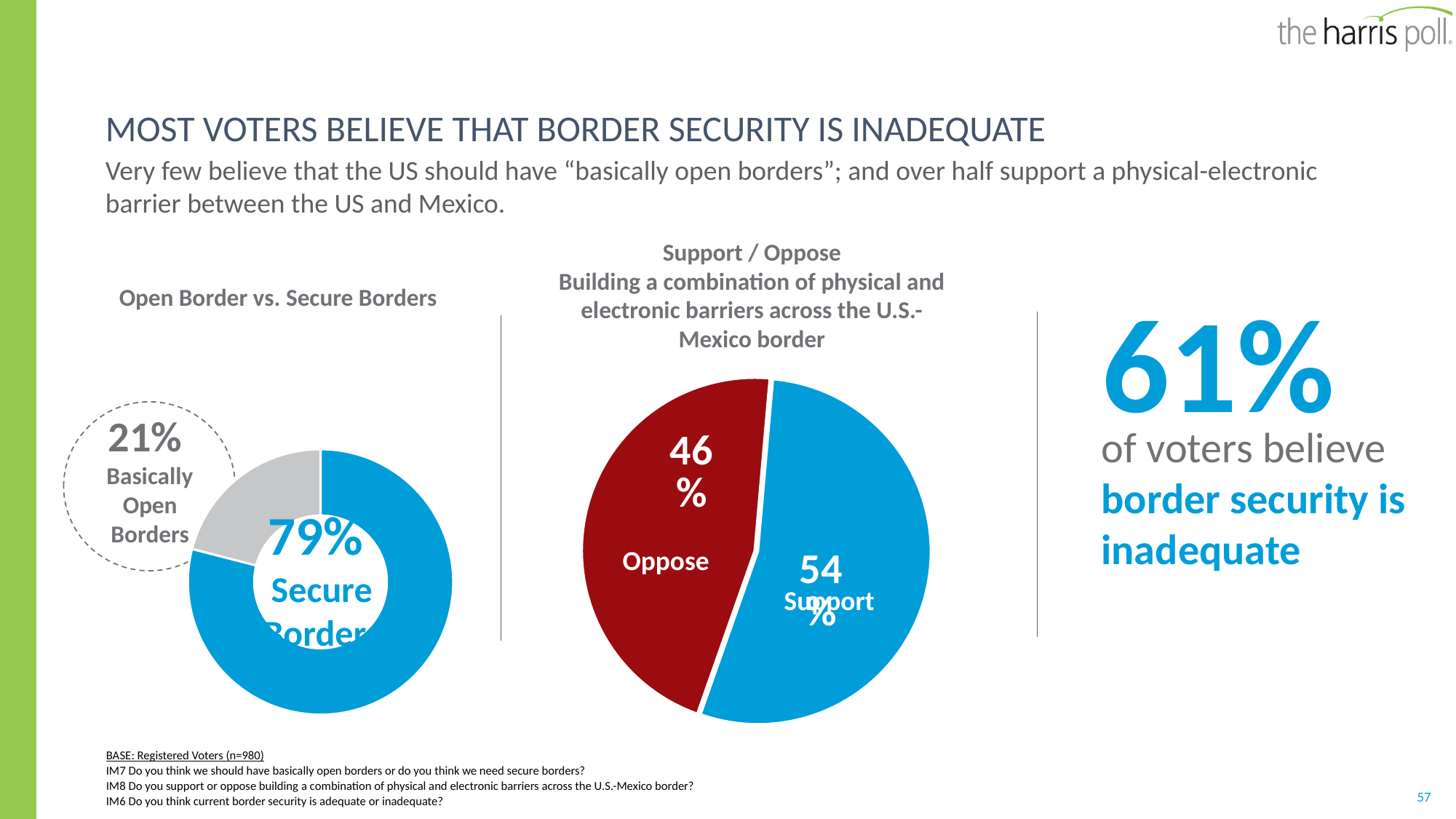
In the 'Open Border vs. Secure Borders' chart, what percentage of voters chose Secure Borders? 79% In the 'Open Border vs. Secure Borders' chart, what is the difference in percentage points between Secure Borders and Basically Open Borders? 58 In the 'Support / Oppose' chart, what is the difference in percentage points between Support and Oppose? 8 In the 'Support / Oppose' chart about building physical and electronic barriers, what percentage of voters oppose it? 46% In the 'Support / Oppose' chart, which is larger, Support or Oppose? Support What kind of chart is the 'Open Border vs. Secure Borders' chart? Donut chart In the 'Open Border vs. Secure Borders' chart, which category has the larger share? Secure Borders How many slices does the 'Support / Oppose' pie chart have? 2 In the 'Open Border vs. Secure Borders' chart, what percentage of voters chose Basically Open Borders? 21% In the 'Support / Oppose' chart, what colour is the Oppose slice? Dark red What kind of chart is the 'Support / Oppose' chart? Pie chart In the 'Support / Oppose' chart about building physical and electronic barriers, what percentage of voters support it? 54%